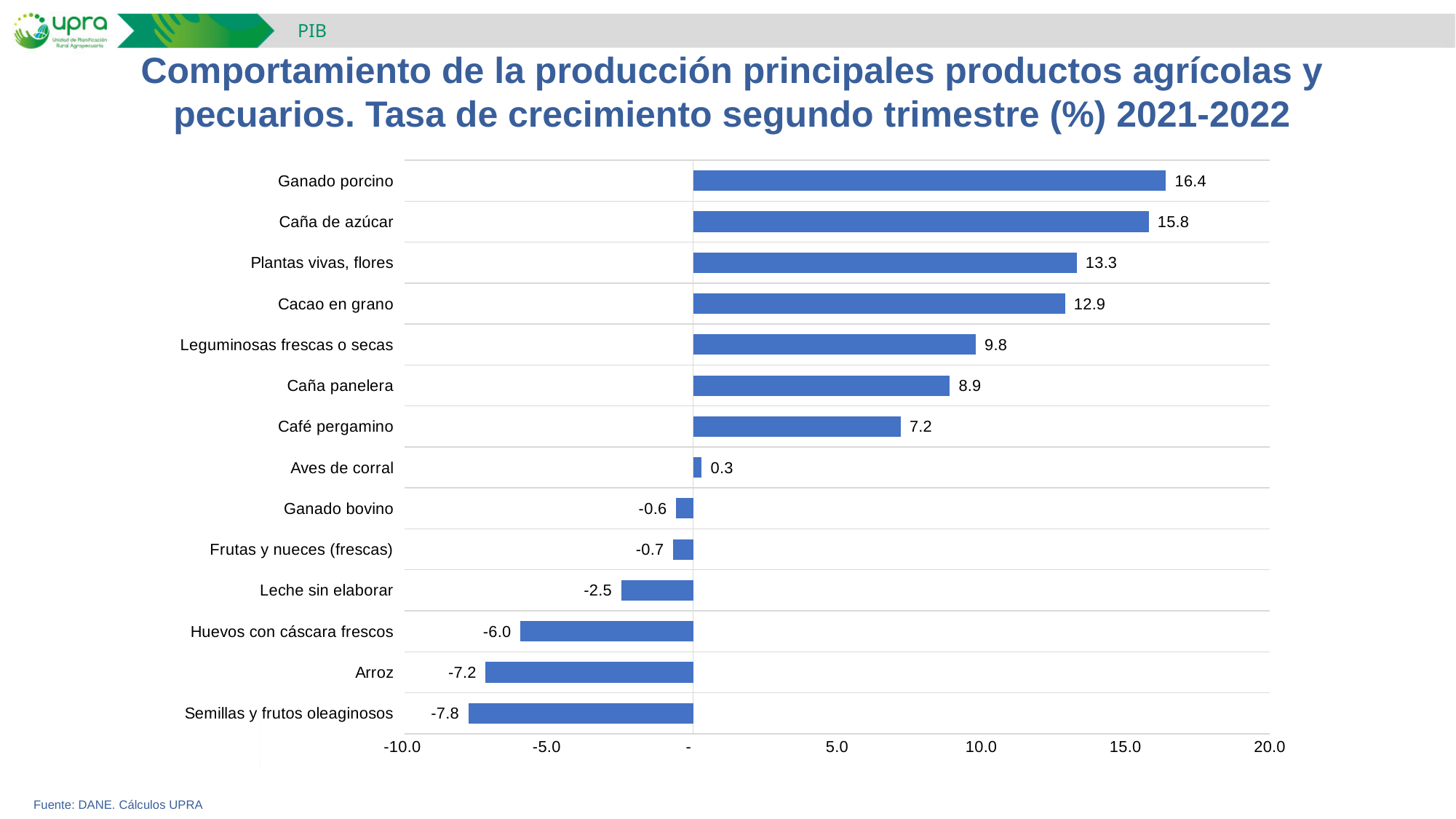
What is the value shown for Aves de corral? 0.3 Is the value for Plantas vivas, flores greater or less than 10.0? greater What is the source cited at the bottom of the slide? DANE. Cálculos UPRA What kind of chart is shown on the slide? Bar chart Which is larger, the value for Leguminosas frescas o secas or the value for Caña panelera? Leguminosas frescas o secas What is the growth rate shown for Ganado porcino? 16.4 Which category has the highest value? Ganado porcino What is the difference between the values for Caña de azúcar and Cacao en grano? 2.9 What is the value shown for Leche sin elaborar? -2.5 How many categories have a negative value? 6 How many categories are shown in the chart? 14 Which category has the lowest value? Semillas y frutos oleaginosos